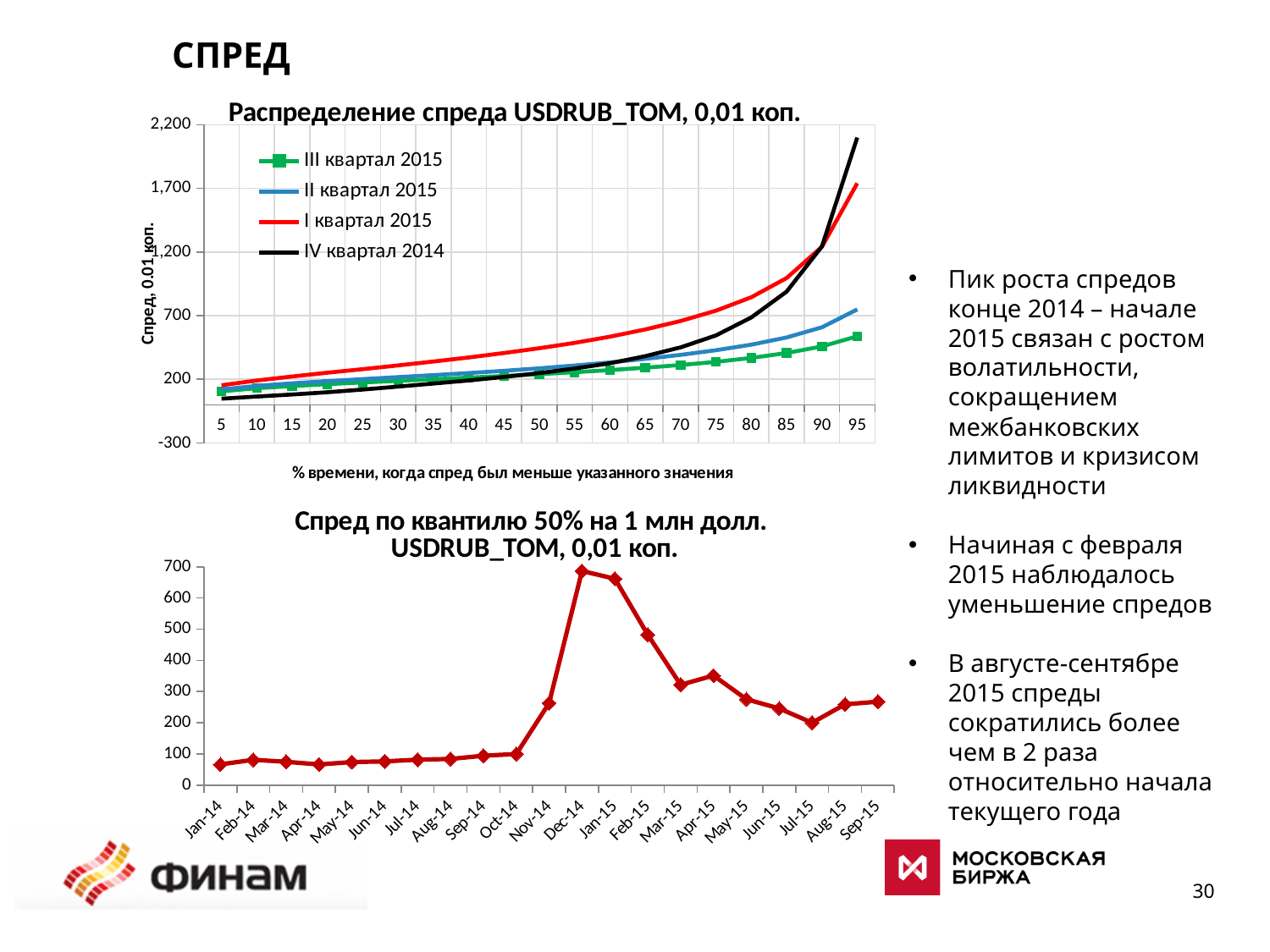
What kind of chart is the top chart titled "Распределение спреда USDRUB_TOM, 0,01 коп."? line chart In the top chart "Распределение спреда USDRUB_TOM, 0,01 коп.", which series has the lowest value at 95 on the x axis? III квартал 2015 In the bottom chart "Спред по квантилю 50% на 1 млн долл. USDRUB_TOM, 0,01 коп.", is the value for Dec-14 greater or less than 600? greater How many series does the legend of the top chart "Распределение спреда USDRUB_TOM, 0,01 коп." list? 4 In the top chart "Распределение спреда USDRUB_TOM, 0,01 коп.", how many x-axis categories are shown? 19 In the bottom chart "Спред по квантилю 50% на 1 млн долл. USDRUB_TOM, 0,01 коп.", which month has the highest value? Dec-14 In the top chart "Распределение спреда USDRUB_TOM, 0,01 коп.", is the value of II квартал 2015 at 95 greater or less than 1,200? less In the bottom chart "Спред по квантилю 50% на 1 млн долл. USDRUB_TOM, 0,01 коп.", which is larger, the value for Apr-15 or the value for Jul-15? Apr-15 In the top chart "Распределение спреда USDRUB_TOM, 0,01 коп.", which series has the highest value at 95 on the x axis? IV квартал 2014 In the bottom chart "Спред по квантилю 50% на 1 млн долл. USDRUB_TOM, 0,01 коп.", do the values rise or fall from Jan-15 to Mar-15? fall In the top chart "Распределение спреда USDRUB_TOM, 0,01 коп.", is the value of IV квартал 2014 at 95 greater or less than 1,700? greater In the top chart "Распределение спреда USDRUB_TOM, 0,01 коп.", what colour is the line for I квартал 2015? red